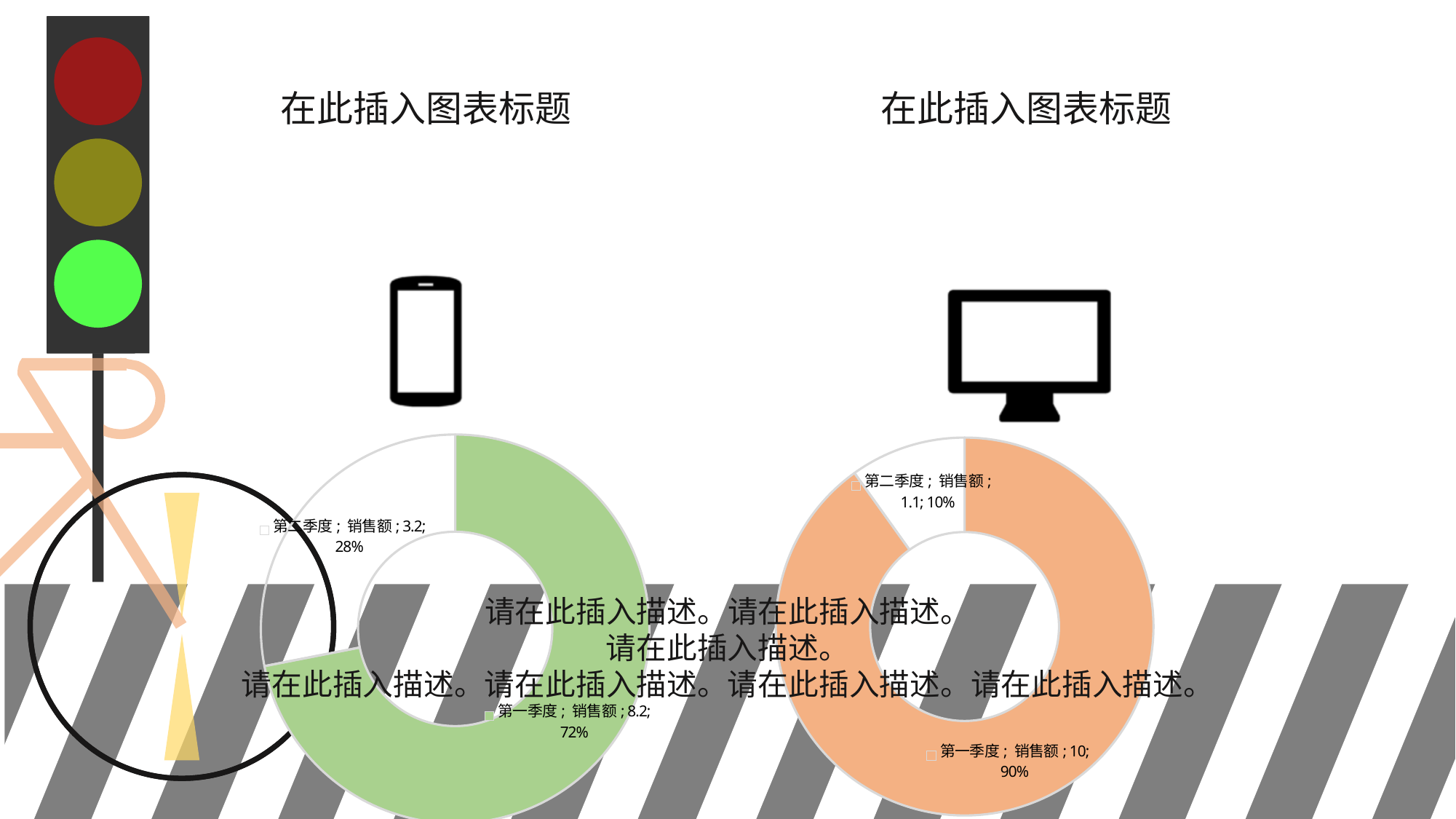
What kind of chart is the chart on the left of the slide? Doughnut chart In the chart on the right of the slide, what is the 销售额 value for 第一季度? 10 In the chart on the left of the slide, what is the 销售额 value for 第一季度? 8.2 In the chart on the right of the slide, which quarter has the smaller 销售额 value? 第二季度 In the chart on the left of the slide, what is the difference between the 销售额 values for 第一季度 and 第二季度? 5 In the chart on the left of the slide, what share of the doughnut does 第二季度 take? 28% How many slices does the chart on the right of the slide have? 2 In the chart on the right of the slide, what is the 销售额 value for 第二季度? 1.1 What colour are the slices in the chart on the right of the slide? Orange and white In the chart on the left of the slide, what share of the doughnut does 第一季度 take? 72% In the chart on the left of the slide, which quarter has the larger 销售额 value? 第一季度 In the chart on the right of the slide, what share of the doughnut does 第二季度 take? 10%